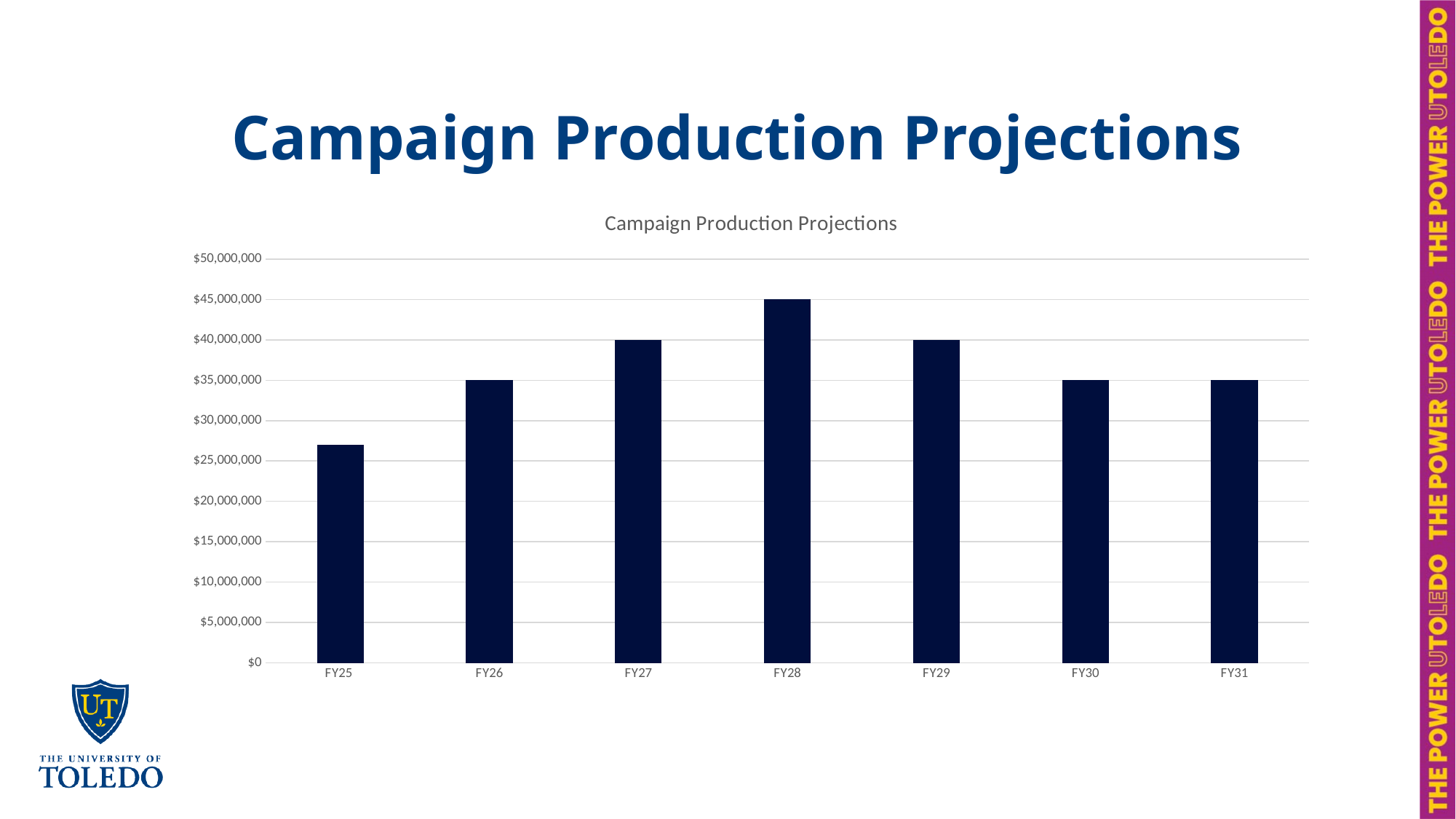
Which fiscal year has the highest projected value? FY28 What is the projected value for FY27? $40,000,000 Which is larger, the value for FY29 or the value for FY30? FY29 Is the value for FY25 greater or less than $30,000,000? less What is the projected value for FY28? $45,000,000 What is the projected value for FY26? $35,000,000 What type of chart is shown on the slide? Bar chart Is the value for FY25 greater or less than $25,000,000? greater Which fiscal year has the lowest projected value? FY25 What is the title of the chart? Campaign Production Projections What is the difference between the values for FY28 and FY31? $10,000,000 How many fiscal years are plotted in the chart? 7